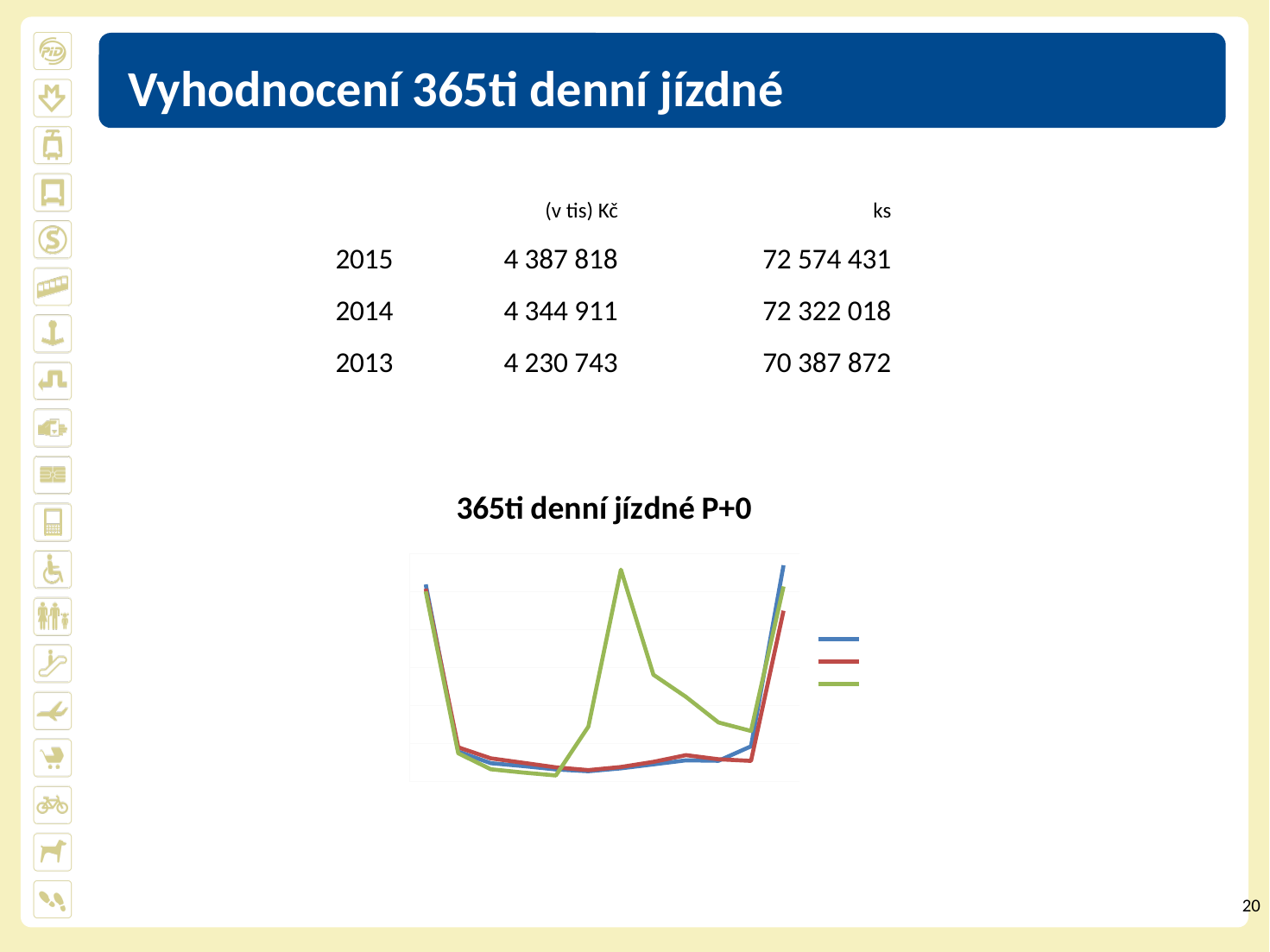
In the "365ti denní jízdné P+0" chart, at the right end of the x axis, which line reaches higher: the blue line or the red line? blue How many series does the legend of the "365ti denní jízdné P+0" chart list? 3 What is the title of the chart on the slide? 365ti denní jízdné P+0 Which coloured line in the "365ti denní jízdné P+0" chart shows a sharp peak in the middle of the x axis? green In the "365ti denní jízdné P+0" chart, do the lines rise or fall between the first and second points on the x axis? fall What kind of chart is shown under the heading "365ti denní jízdné P+0"? line chart